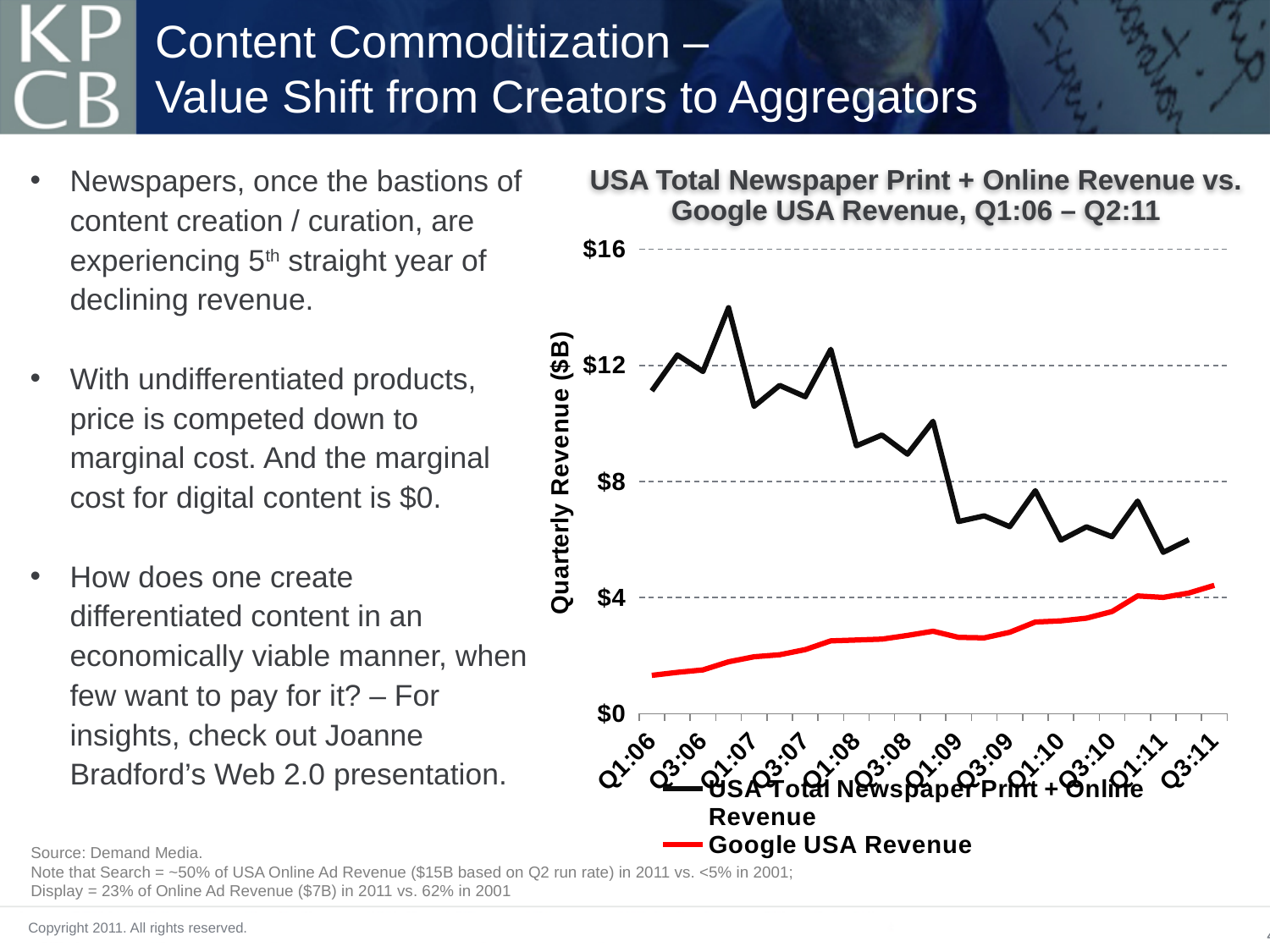
At Q1:06, which series has the larger value: USA Total Newspaper Print + Online Revenue or Google USA Revenue? USA Total Newspaper Print + Online Revenue Is the USA Total Newspaper Print + Online Revenue value at Q1:07 greater or less than $12? less Is the USA Total Newspaper Print + Online Revenue value at Q1:06 greater or less than $8? greater What kind of chart is shown on the slide? Line chart Does the Google USA Revenue line rise or fall overall from Q1:06 to Q2:11? Rise What is the title of the chart? USA Total Newspaper Print + Online Revenue vs. Google USA Revenue, Q1:06 – Q2:11 Does the USA Total Newspaper Print + Online Revenue line rise or fall overall from Q1:06 to Q2:11? Fall What is the label on the chart's vertical axis? Quarterly Revenue ($B) How many series does the chart's legend list? 2 In which quarter does the USA Total Newspaper Print + Online Revenue line reach its highest point? Q4:06 Is the Google USA Revenue value at Q1:06 greater or less than $4? less